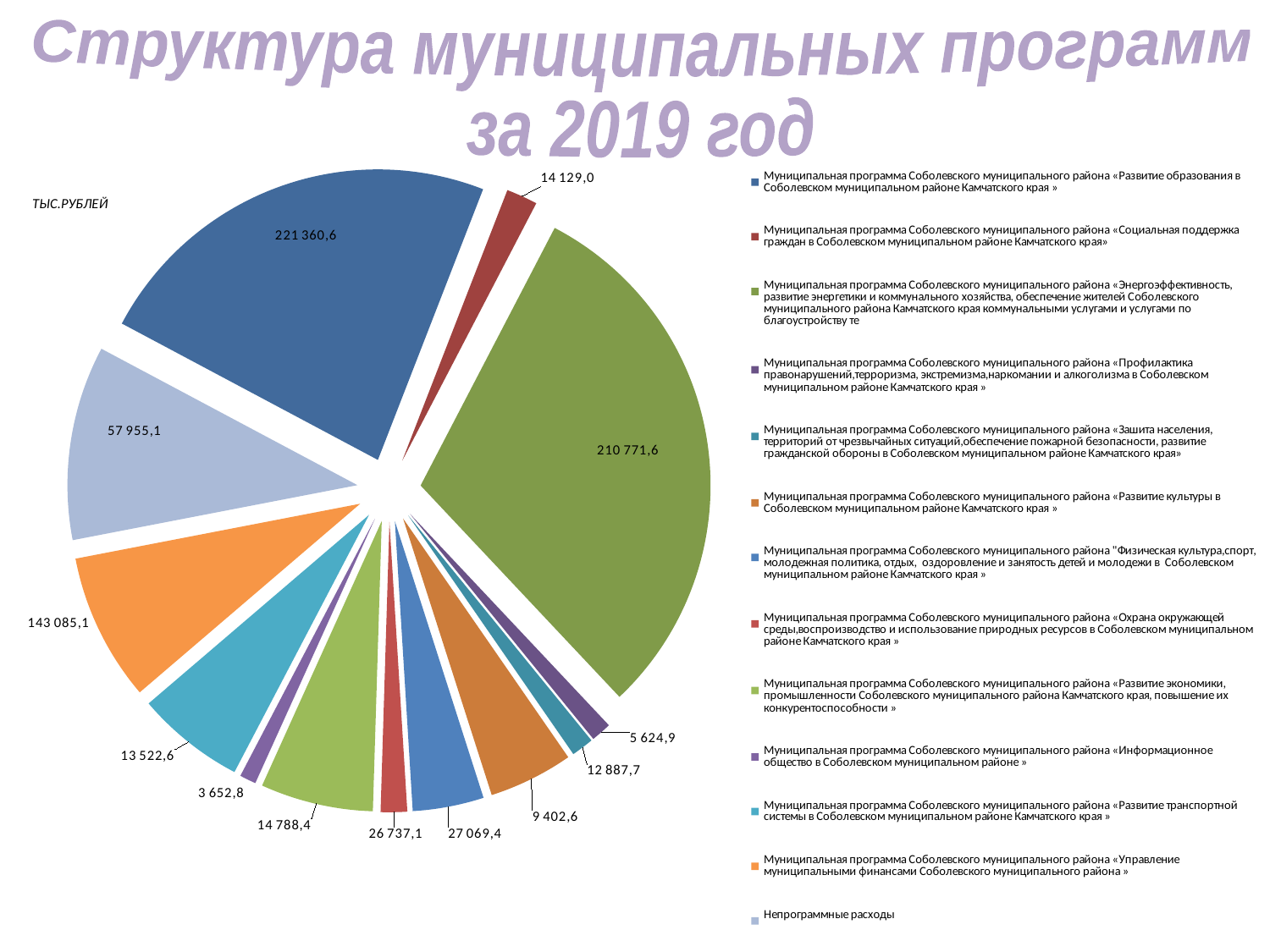
What is the value for the municipal program «Информационное общество в Соболевском муниципальном районе»? 3 652,8 Which is larger: the value for «Развитие транспортной системы» or the value for «Защита населения, территорий от чрезвычайных ситуаций...»? «Развитие транспортной системы» (13 522,6) How many slices does the pie chart have? 13 What is the difference between the value for «Развитие образования» (221 360,6) and the value for «Энергоэффективность, развитие энергетики и коммунального хозяйства...» (210 771,6)? 10 589,0 What is the value for the municipal program «Управление муниципальными финансами Соболевского муниципального района»? 143 085,1 In what units are the values on the chart given, according to the note on the slide? ТЫС.РУБЛЕЙ What type of chart is shown on the slide? pie chart What is the value for the municipal program «Развитие образования в Соболевском муниципальном районе Камчатского края»? 221 360,6 Which category has the smallest slice of the pie? Муниципальная программа «Информационное общество в Соболевском муниципальном районе» What is the value for «Непрограммные расходы»? 57 955,1 What is the difference between the value for «Управление муниципальными финансами» and the value for «Непрограммные расходы»? 85 130,0